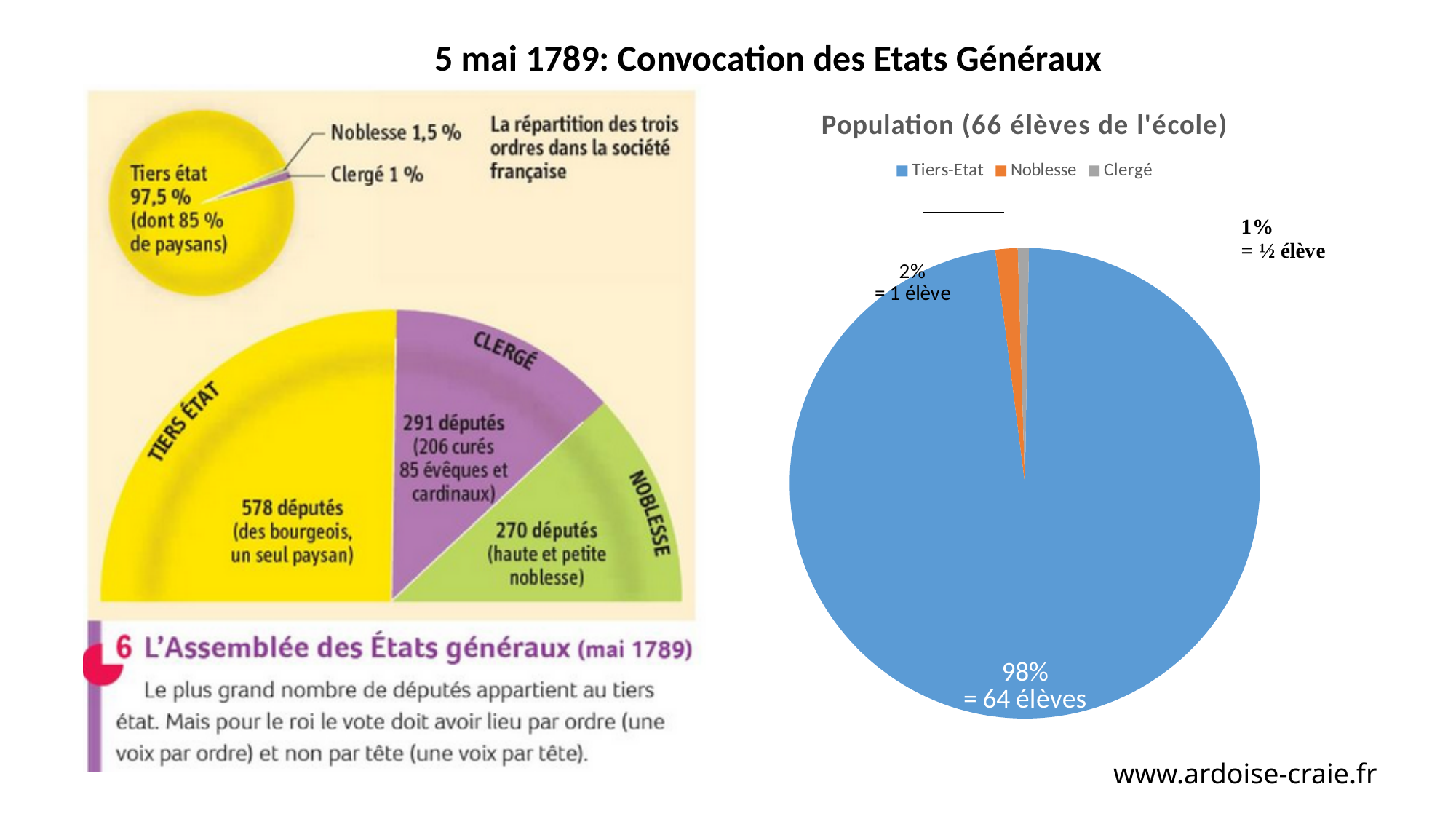
In the chart titled "Population (66 élèves de l'école)", how many series does the legend list? 3 In the chart titled "Population (66 élèves de l'école)", which category has the largest slice? Tiers-Etat In the chart titled "Population (66 élèves de l'école)", what is the difference in percentage points between the Tiers-Etat share and the Noblesse share? 96 In the chart titled "Population (66 élèves de l'école)", how many élèves does the Noblesse slice represent? 1 élève In the chart titled "Population (66 élèves de l'école)", what colour is the Tiers-Etat slice? blue In the chart titled "Population (66 élèves de l'école)", what percentage share is shown for Clergé? 1% In the chart titled "Population (66 élèves de l'école)", how many élèves does the Tiers-Etat slice represent? 64 élèves In the chart titled "Population (66 élèves de l'école)", what kind of chart is shown? pie chart In the chart titled "Population (66 élèves de l'école)", what percentage share is shown for Noblesse? 2% In the chart titled "Population (66 élèves de l'école)", which category has the smallest slice? Clergé In the small pie chart at the top left of the slide ("La répartition des trois ordres dans la société française"), what percentage is shown for Noblesse? 1,5 % In the chart titled "Population (66 élèves de l'école)", what percentage share is shown for Tiers-Etat? 98%